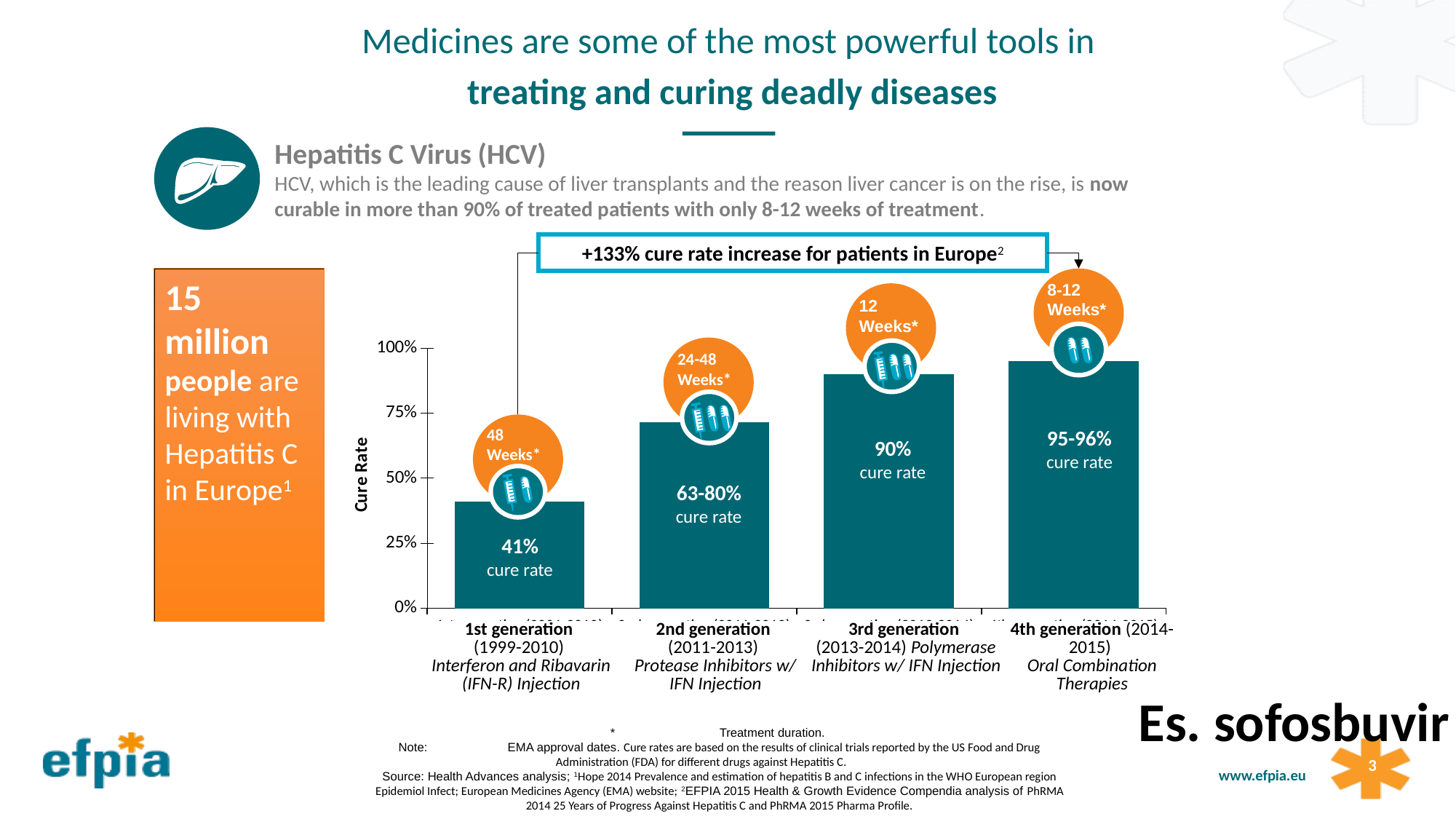
What type of chart is used to show the cure rates? bar chart What cure rate is labelled on the 3rd generation bar? 90% What treatment duration is shown for the 1st generation treatment? 48 Weeks Is the cure rate for the 1st generation greater or less than 50%? less What treatment duration is shown for the 4th generation treatment? 8-12 Weeks Which generation has the lowest cure rate? 1st generation What cure rate is labelled on the 2nd generation bar? 63-80% Which generation has the highest cure rate? 4th generation How many generations of treatment are shown on the chart? 4 What cure rate is labelled on the 4th generation (Oral Combination Therapies) bar? 95-96% Do the cure rates rise or fall from the 1st generation to the 4th generation? rise What is the cure rate shown for the 1st generation treatment? 41%